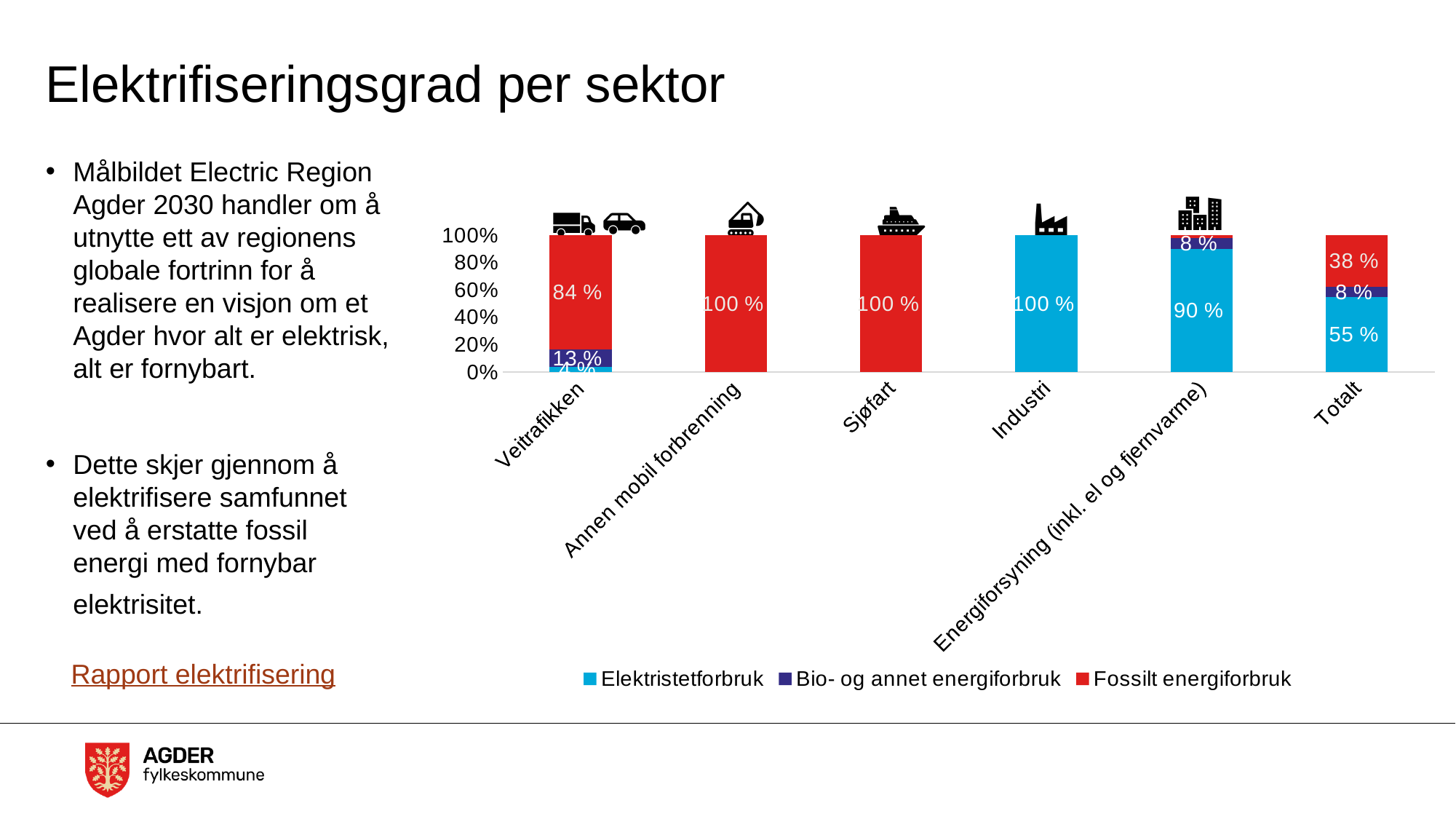
What kind of chart is shown on the slide? Stacked bar chart What is the share of Elektristetforbruk for Industri? 100 % What is the share of Elektristetforbruk for Totalt? 55 % What is the share of Elektristetforbruk for Energiforsyning (inkl. el og fjernvarme)? 90 % What is the share of Fossilt energiforbruk for Totalt? 38 % How many sectors (categories) are shown on the x axis of the chart? 6 What is the difference between the Elektristetforbruk share and the Fossilt energiforbruk share for Totalt? 17 % What is the share of Bio- og annet energiforbruk for Veitrafikken? 13 % What is the share of Fossilt energiforbruk for Veitrafikken? 84 % Which is larger for Totalt: the Elektristetforbruk share or the Fossilt energiforbruk share? Elektristetforbruk How many series does the chart legend list? 3 Which colour represents Fossilt energiforbruk in the chart? Red